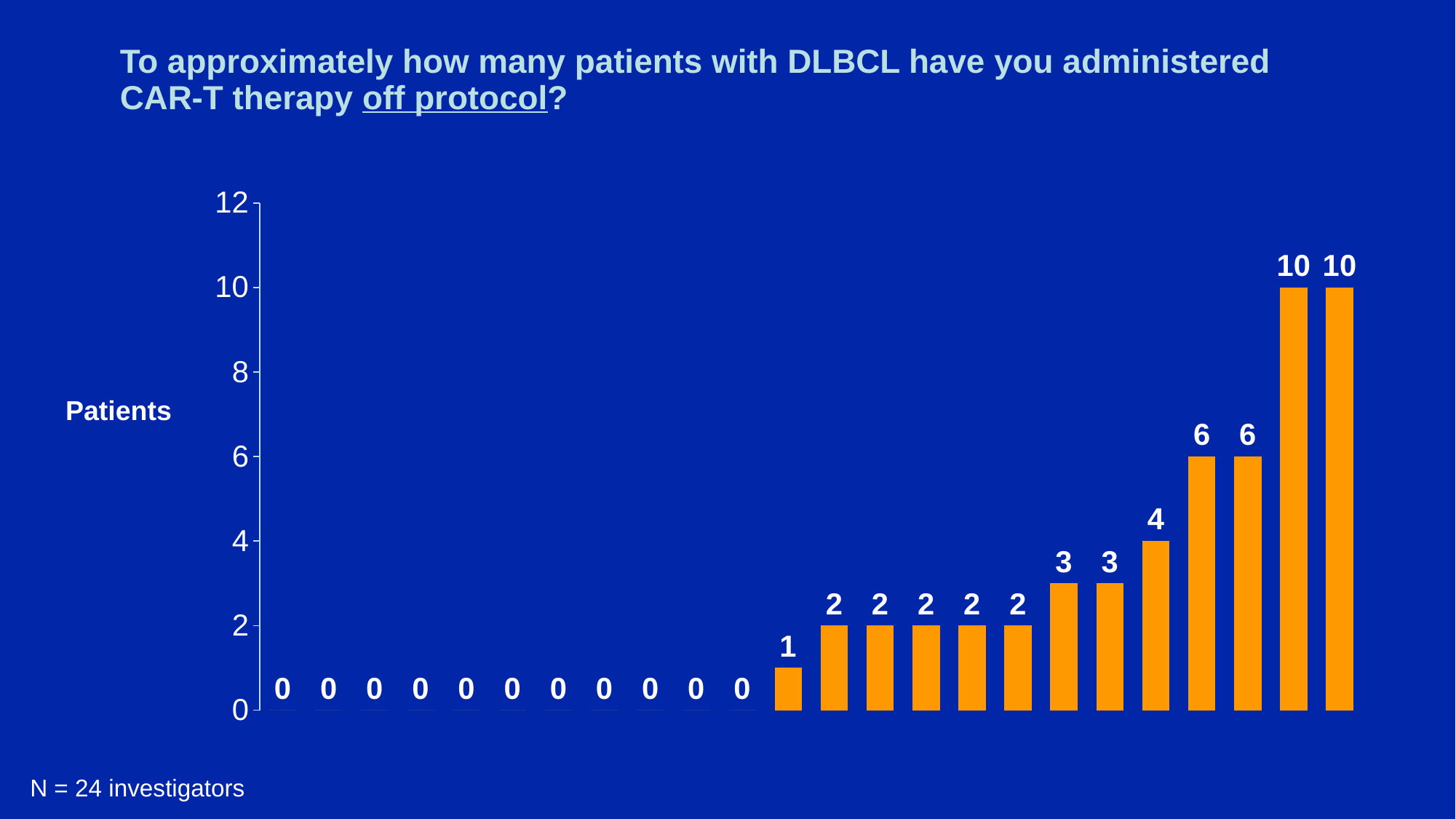
What is the value of the first non-zero bar from the left? 1 What is the label on the vertical axis of the chart? Patients What is the lowest value shown in the chart? 0 Do the bar values rise or fall from left to right across the chart? rise How many bars in the chart have a value of 10? 2 How many bars in the chart have a value of 2? 5 What is the highest value shown in the chart? 10 How many bars (investigators) are plotted in the chart? 24 What is the value of the rightmost bar in the chart? 10 What is the difference between the highest and lowest bar values in the chart? 10 What kind of chart is shown on the slide? bar chart